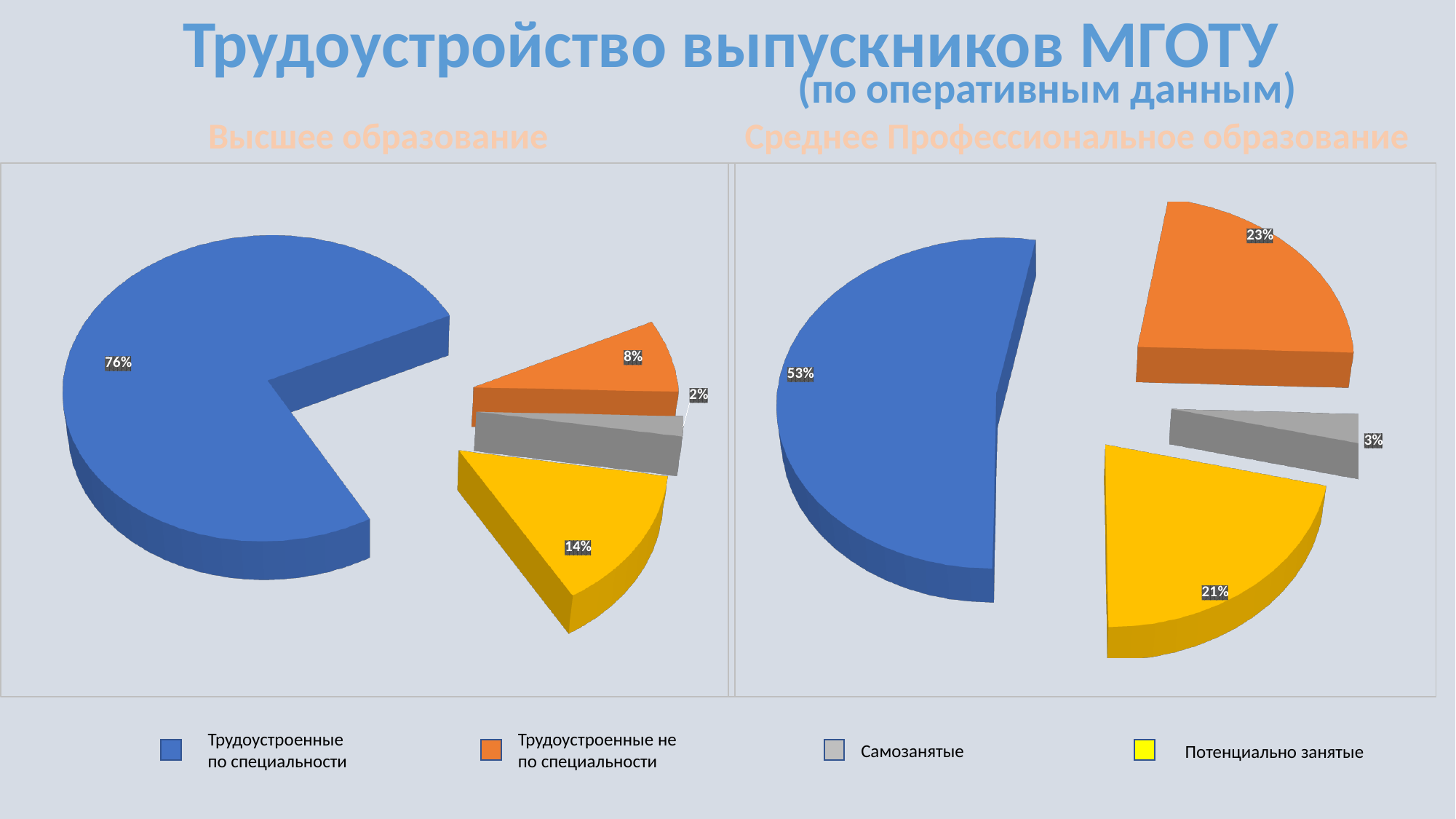
In the 'Высшее образование' pie chart, what is the difference between the shares of 'Потенциально занятые' and 'Трудоустроенные не по специальности'? 6% In the 'Среднее Профессиональное образование' pie chart, what share is shown for 'Трудоустроенные не по специальности'? 23% In the 'Среднее Профессиональное образование' pie chart, which is larger: 'Трудоустроенные не по специальности' or 'Потенциально занятые'? Трудоустроенные не по специальности In the 'Среднее Профессиональное образование' pie chart, what share is shown for 'Потенциально занятые'? 21% In the 'Высшее образование' pie chart, what share is shown for 'Самозанятые'? 2% How many categories does the legend list? 4 In the 'Высшее образование' pie chart, what share is shown for 'Трудоустроенные по специальности'? 76% Which chart shows a larger share for 'Трудоустроенные по специальности': 'Высшее образование' or 'Среднее Профессиональное образование'? Высшее образование In the 'Среднее Профессиональное образование' pie chart, which category has the smallest share? Самозанятые How many slices does the 'Высшее образование' pie chart have? 4 In the 'Высшее образование' pie chart, which category has the largest share? Трудоустроенные по специальности What type of chart is used on this slide? Pie chart